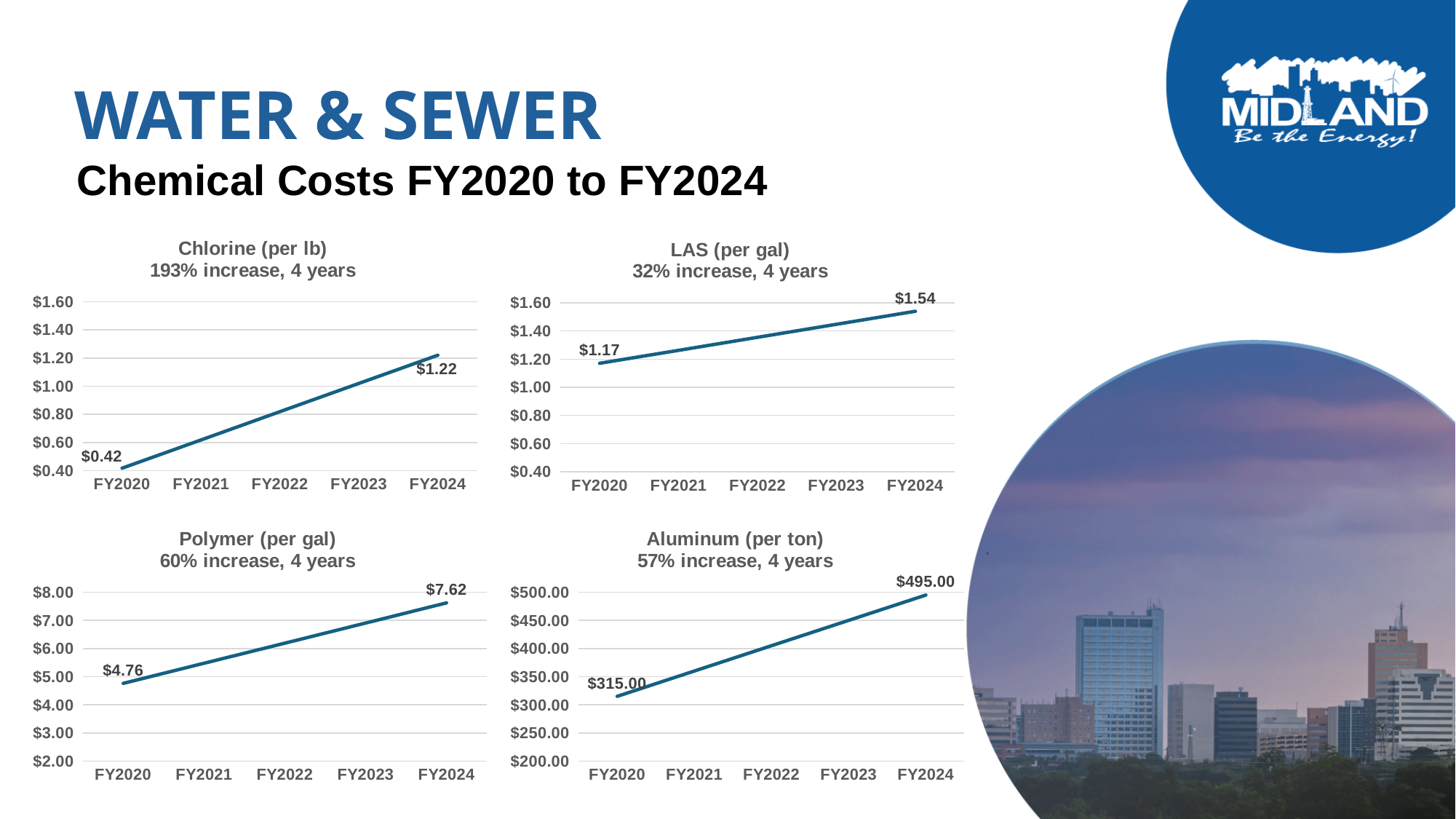
What kind of chart is the Aluminum (per ton) chart? line chart In the Polymer (per gal) chart, what is the difference between the FY2024 and FY2020 values? $2.86 In the LAS (per gal) chart, which is larger, the FY2020 value or the FY2024 value? FY2024 In the Aluminum (per ton) chart, what is the value for FY2024? $495.00 In the Chlorine (per lb) chart, what is the value for FY2024? $1.22 In the Polymer (per gal) chart, what is the value for FY2020? $4.76 How many fiscal years are shown on the x axis of the Polymer (per gal) chart? 5 In the Chlorine (per lb) chart, do the values rise or fall from FY2020 to FY2024? rise In the Aluminum (per ton) chart, what is the difference between the FY2024 and FY2020 values? $180.00 In the LAS (per gal) chart, what is the value for FY2024? $1.54 According to the Chlorine (per lb) chart title, what is the percentage increase over 4 years? 193% In the Chlorine (per lb) chart, what is the value for FY2020? $0.42